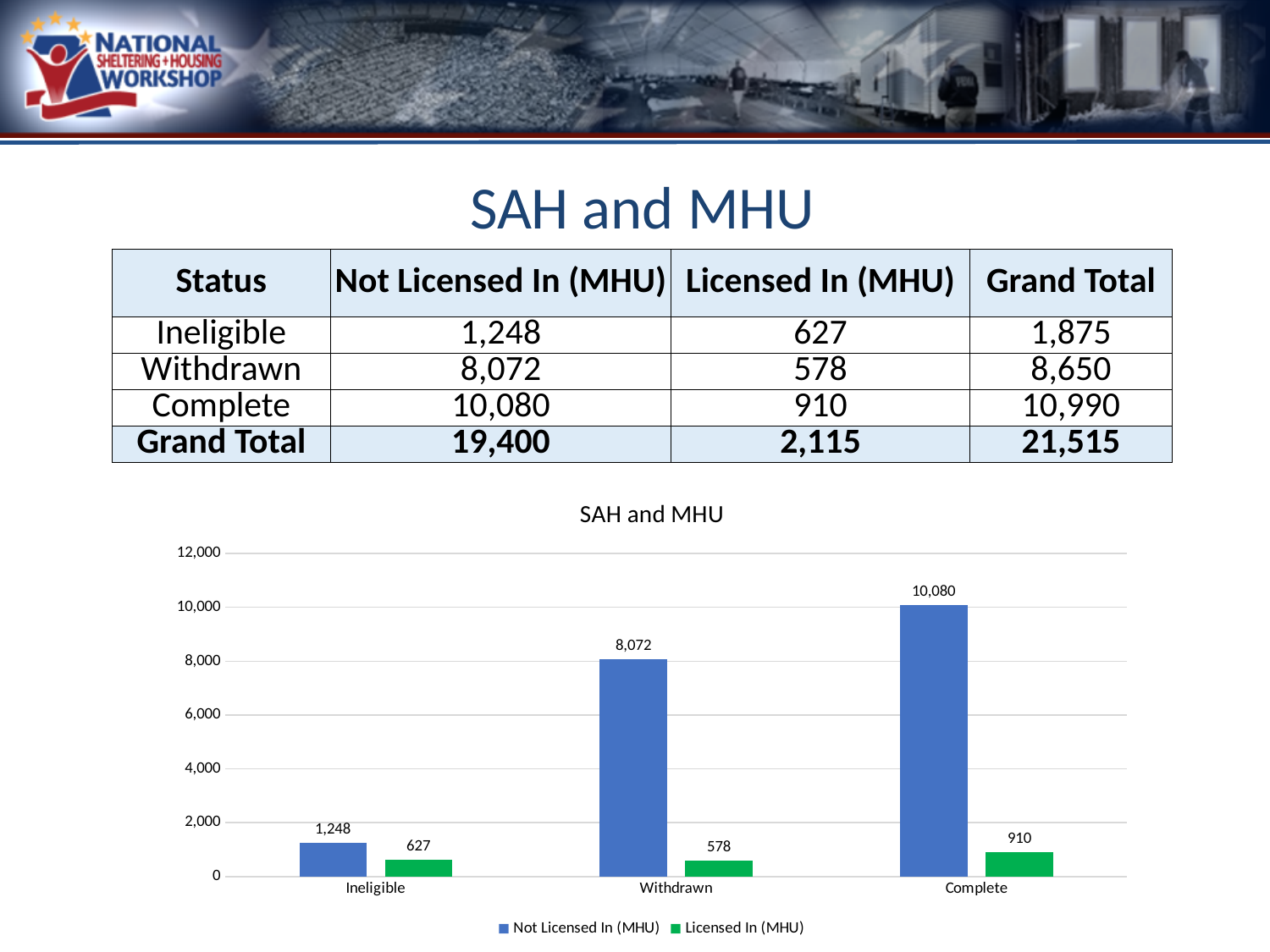
Is the Not Licensed In (MHU) value for Withdrawn greater or less than 8,000? greater What is the value for Licensed In (MHU) in the Complete category? 910 Which category has the lowest Licensed In (MHU) value? Withdrawn Which category has the highest Not Licensed In (MHU) value? Complete What is the value for Licensed In (MHU) in the Ineligible category? 627 What kind of chart is shown on the slide? bar chart What is the difference between the Not Licensed In (MHU) and Licensed In (MHU) values for Complete? 9,170 What is the title of the chart? SAH and MHU How many series does the chart legend list? 2 How many categories are shown on the x axis of the chart? 3 What is the value for Not Licensed In (MHU) in the Withdrawn category? 8,072 Which is larger: the Licensed In (MHU) value for Ineligible or for Withdrawn? Ineligible